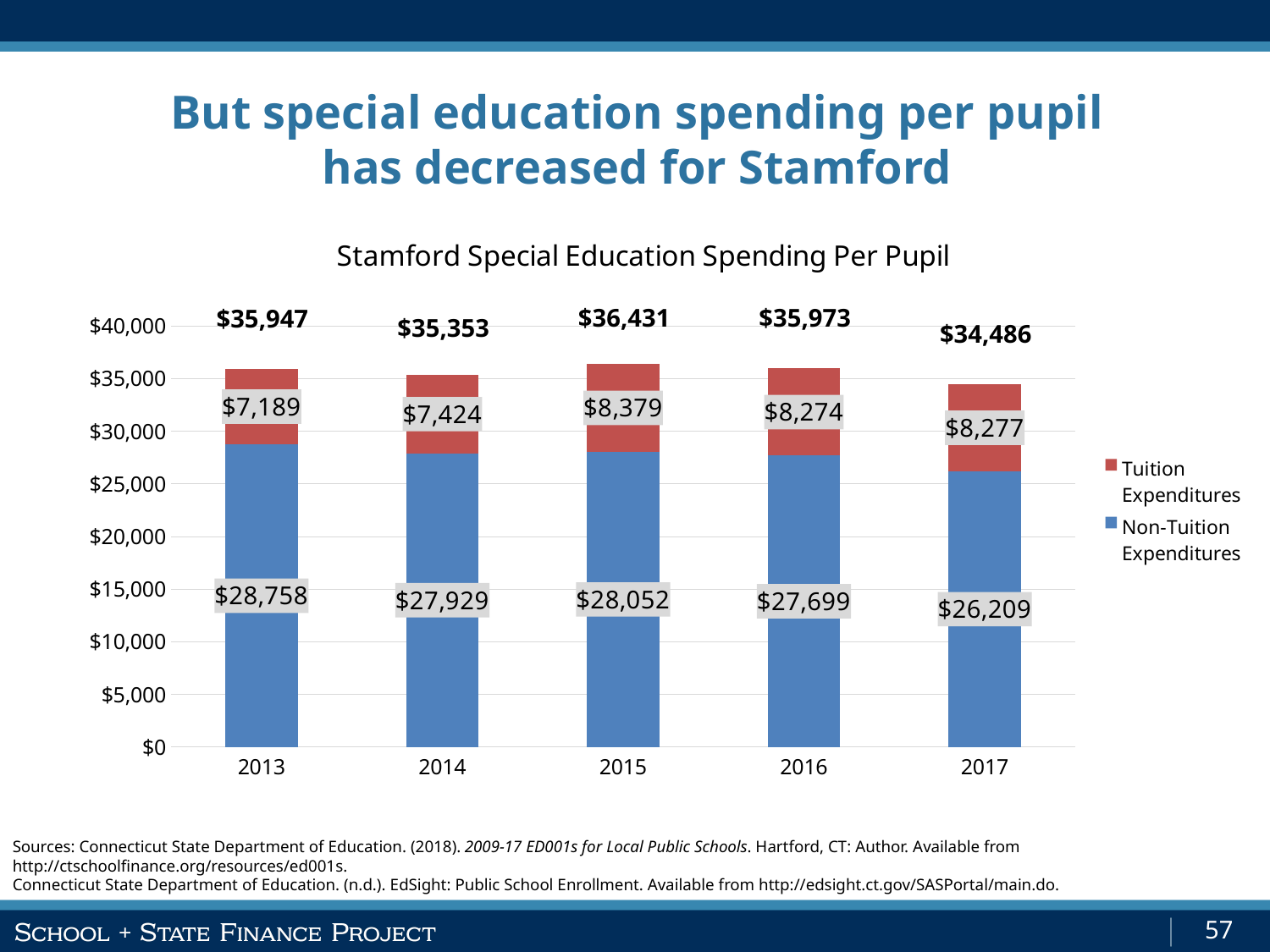
Is the total spending per pupil for 2015 greater or less than $35,000? greater How many series does the legend list? 2 What is the Non-Tuition Expenditures value for 2013? $28,758 What is the total special education spending per pupil shown for 2017? $34,486 How many years are shown on the x axis? 5 What is the Tuition Expenditures value for 2015? $8,379 Which series is shown in red? Tuition Expenditures What kind of chart is shown on the slide? Stacked bar chart Which year has the highest total spending per pupil? 2015 Which is larger, the Tuition Expenditures value for 2013 or for 2014? 2014 What is the difference between the Non-Tuition Expenditures values for 2013 and 2017? $2,549 Which year has the lowest Non-Tuition Expenditures value? 2017